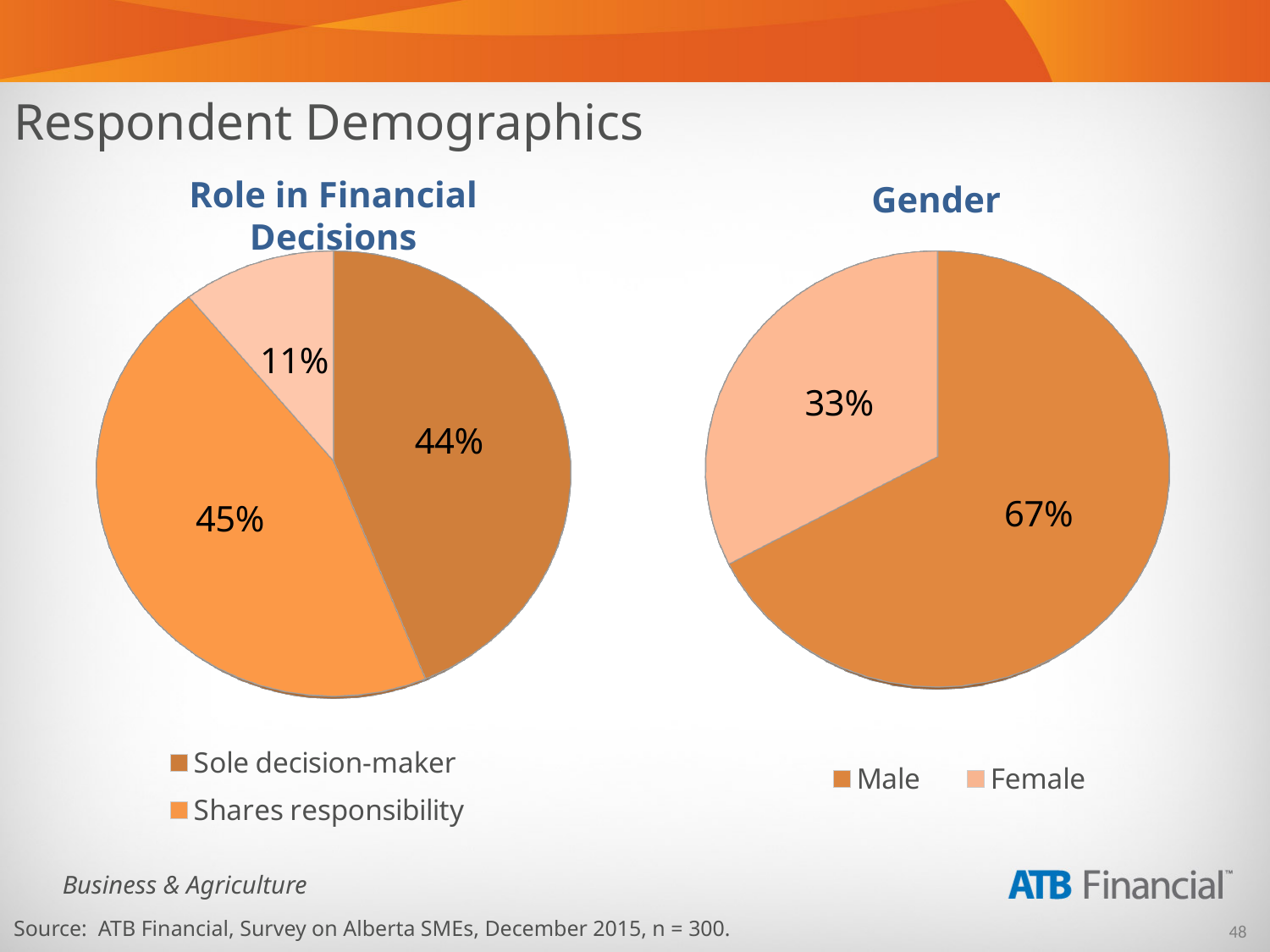
In the Role in Financial Decisions chart, what percentage of respondents share responsibility? 45% How many slices does the Role in Financial Decisions pie chart have? 3 What is the title of the chart on the right side of the slide? Gender In the Gender chart, what percentage of respondents are Male? 67% In the Role in Financial Decisions chart, what percentage of respondents are sole decision-makers? 44% How many entries does the legend of the Gender chart list? 2 In the Gender chart, which category has the larger share? Male In the Gender chart, what percentage of respondents are Female? 33% In the Gender chart, which category has the smaller share? Female In the Role in Financial Decisions chart, which is larger: Sole decision-maker or Shares responsibility? Shares responsibility What type of chart is the Gender chart? Pie chart In the Gender chart, what is the difference in percentage points between Male and Female? 34